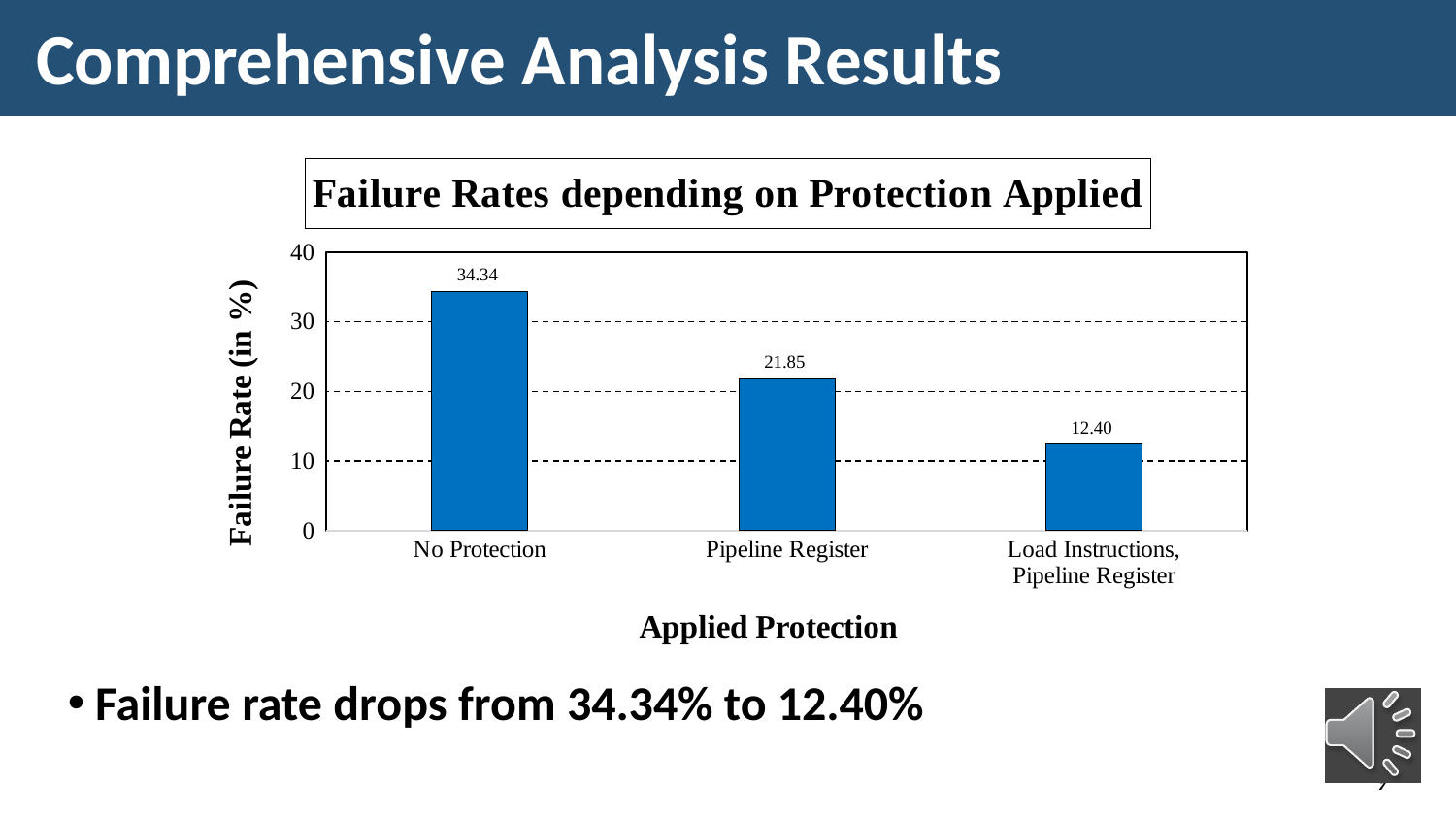
Which applied protection has the highest failure rate? No Protection What is the title of the chart? Failure Rates depending on Protection Applied What is the difference in failure rate between No Protection and Load Instructions, Pipeline Register? 21.94 What is the difference in failure rate between No Protection and Pipeline Register? 12.49 What is the failure rate for Load Instructions, Pipeline Register? 12.40 What kind of chart is shown on the slide? Bar chart Which applied protection has the lowest failure rate? Load Instructions, Pipeline Register How many applied protection categories are shown in the chart? 3 Which has a larger failure rate, Pipeline Register or Load Instructions, Pipeline Register? Pipeline Register What is the failure rate for No Protection? 34.34 What is the failure rate for Pipeline Register? 21.85 Is the failure rate for Pipeline Register greater or less than 20? greater